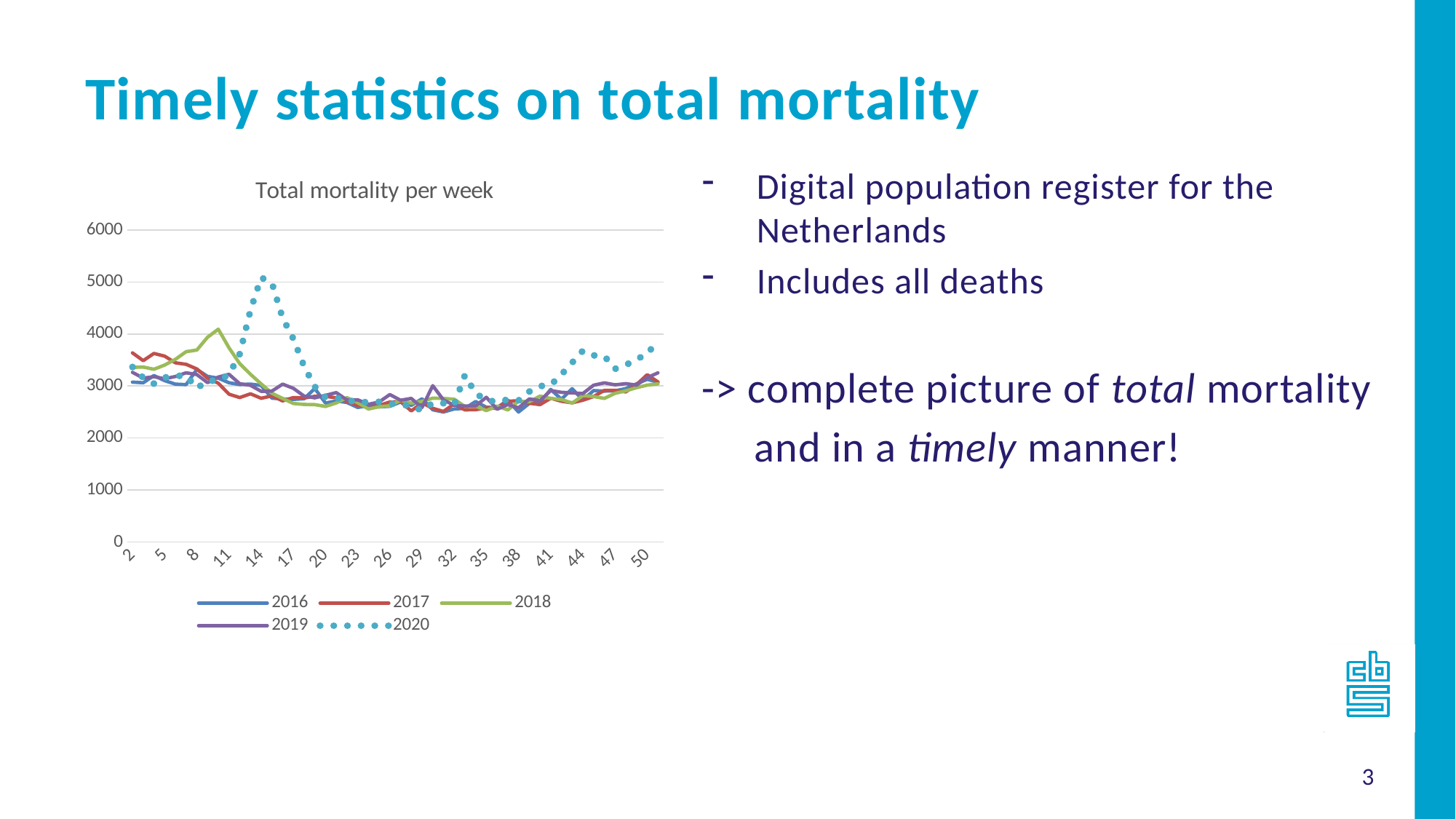
Which series has the highest value at week 11, 2018 or 2016? 2018 Is the value for 2018 at week 11 greater or less than 3500? greater Does the 2020 series rise or fall between week 11 and week 14? rise What kind of chart is shown on the slide? line chart How many series does the legend of the chart list? 5 Is the value for 2020 at week 14 greater or less than 4000? greater Which series has the highest value at week 14? 2020 Is the value for 2017 at week 26 greater or less than 3000? less What is the highest value shown on the vertical axis of the chart? 6000 Which series in the chart is drawn with a dotted line? 2020 What is the title of the chart? Total mortality per week